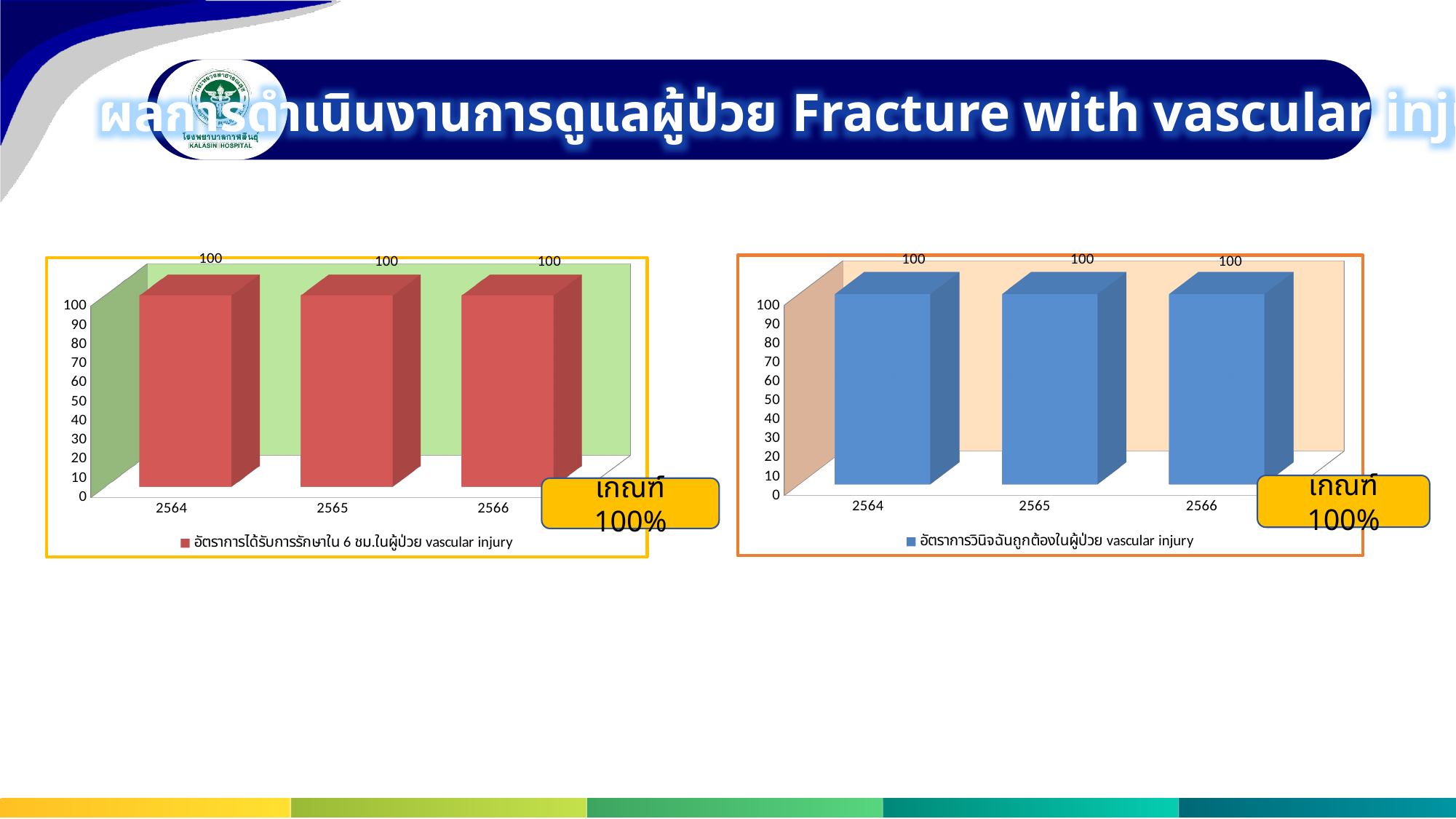
How many series does the legend of the left chart list? 1 How many categories are shown on the x axis of the left chart? 3 What is the legend entry of the right chart? อัตราการวินิจฉันถูกต้องในผู้ป่วย vascular injury In the right chart, what is the value for 2566? 100 How many categories are shown on the x axis of the right chart? 3 In the right chart, do the values rise, fall, or stay the same from 2564 to 2566? Stay the same What kind of chart is the left chart? Bar chart In the left chart, what is the difference between the values for 2565 and 2564? 0 In the left chart, what is the value for 2566? 100 In the right chart, what is the difference between the values for 2566 and 2564? 0 In the left chart, what is the value for 2564? 100 In the right chart, what is the value for 2565? 100